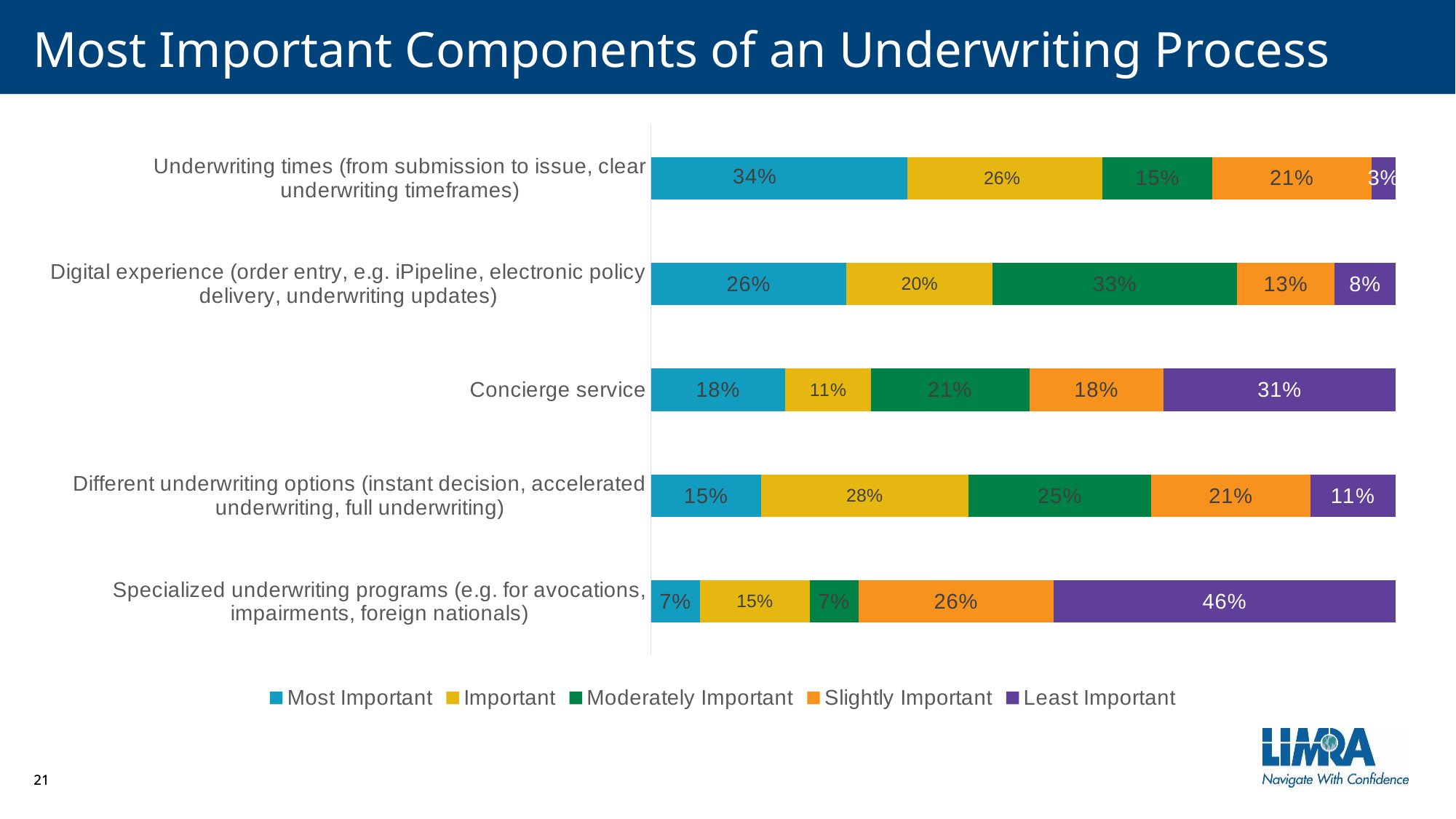
What percentage rated Digital experience as Moderately Important? 33% Which component has the highest Most Important percentage? Underwriting times (from submission to issue, clear underwriting timeframes) Which colour represents the Least Important series in the legend? Purple What type of chart is shown on the slide? Stacked bar chart What is the difference between the Least Important percentages for Specialized underwriting programs and Concierge service? 15% What percentage rated Underwriting times as Most Important? 34% What percentage rated Concierge service as Important? 11% Which is larger: the Important percentage for Different underwriting options or for Digital experience? Different underwriting options How many series does the legend list? 5 How many components are shown in the chart? 5 Which component has the lowest Least Important percentage? Underwriting times (from submission to issue, clear underwriting timeframes) What percentage rated Specialized underwriting programs as Least Important? 46%